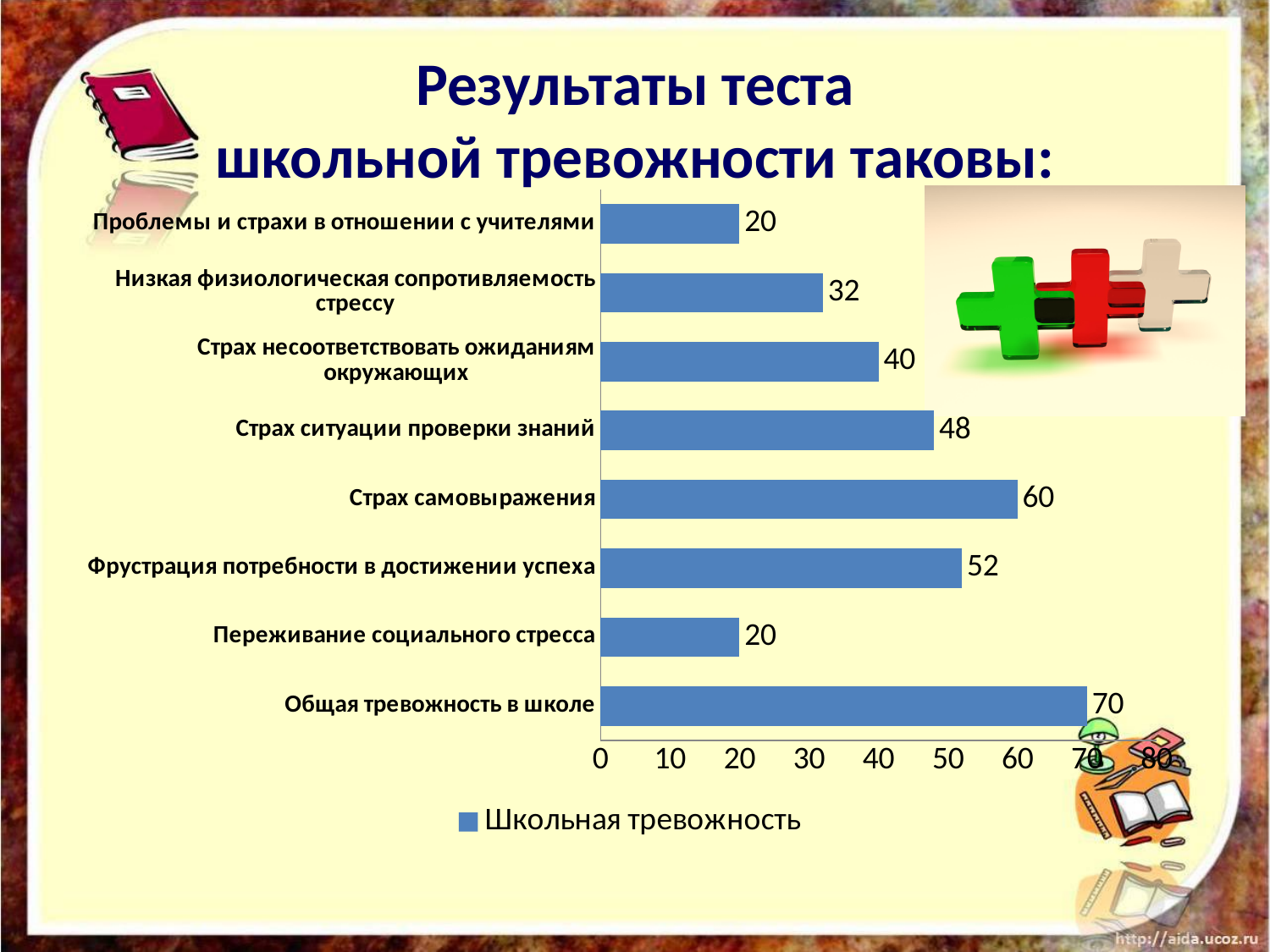
What is the value for «Общая тревожность в школе»? 70 What is the difference between «Страх самовыражения» and «Фрустрация потребности в достижении успеха»? 8 Which category has the highest value? Общая тревожность в школе How many categories are shown in the chart? 8 Which is larger: «Страх ситуации проверки знаний» or «Страх несоответствовать ожиданиям окружающих»? Страх ситуации проверки знаний Which categories share the lowest value of 20? Проблемы и страхи в отношении с учителями; Переживание социального стресса What is the name of the series in the legend? Школьная тревожность What is the value for «Страх самовыражения»? 60 How many series does the legend list? 1 Is the value for «Фрустрация потребности в достижении успеха» greater or less than 50? greater What kind of chart is shown on the slide? bar chart What is the value for «Низкая физиологическая сопротивляемость стрессу»? 32